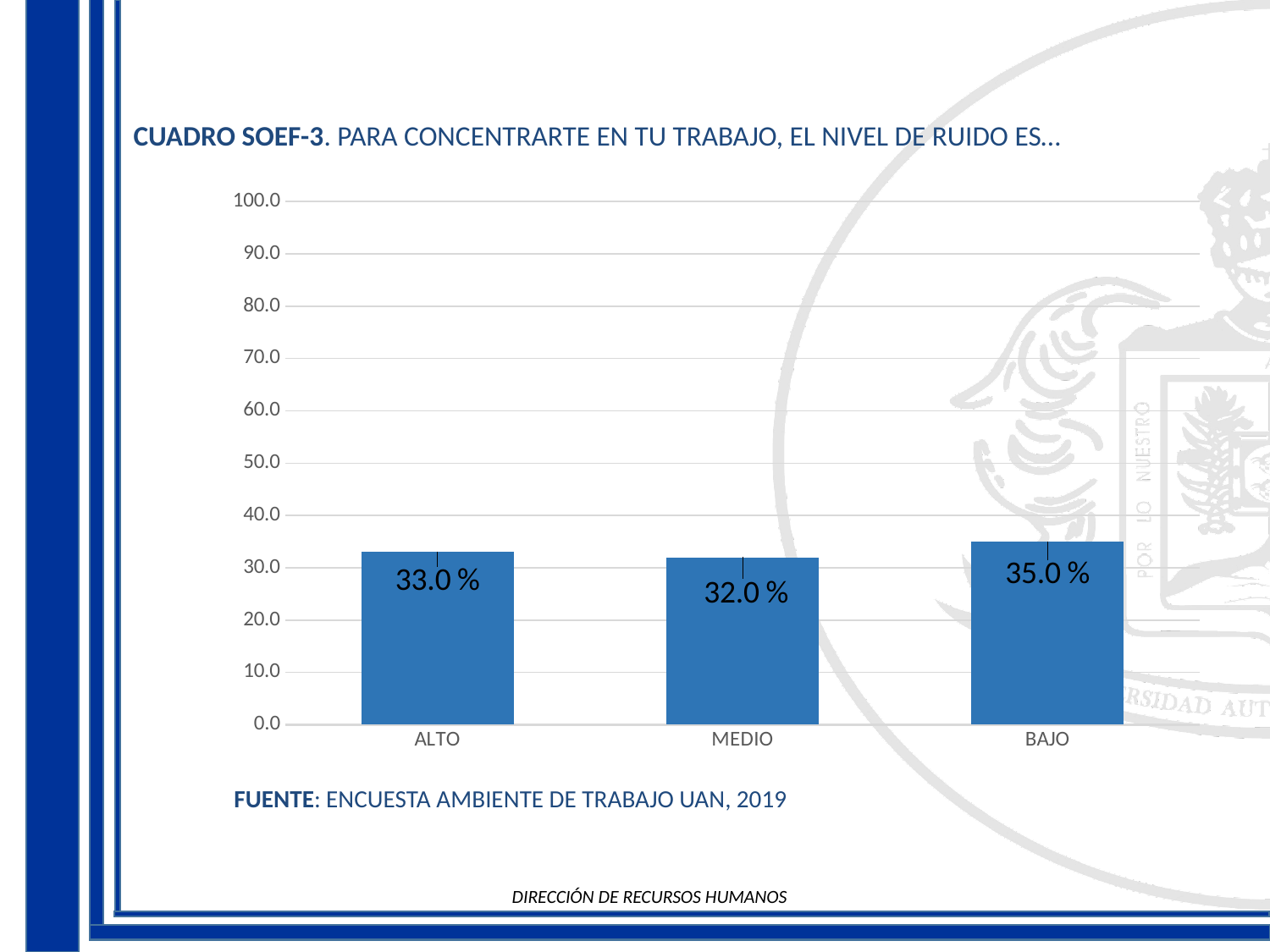
What kind of chart is shown on the slide? bar chart Which is larger, the value for BAJO or the value for ALTO? BAJO What source is cited below the chart? ENCUESTA AMBIENTE DE TRABAJO UAN, 2019 What is the value for MEDIO? 32.0 % Is the value for BAJO greater or less than 40.0? less What is the difference between the values for BAJO and MEDIO? 3.0 % What is the value for BAJO? 35.0 % Which category has the lowest value? MEDIO What is the value for ALTO? 33.0 % What is the difference between the values for ALTO and MEDIO? 1.0 % Which category has the highest value? BAJO How many categories are shown on the x axis? 3